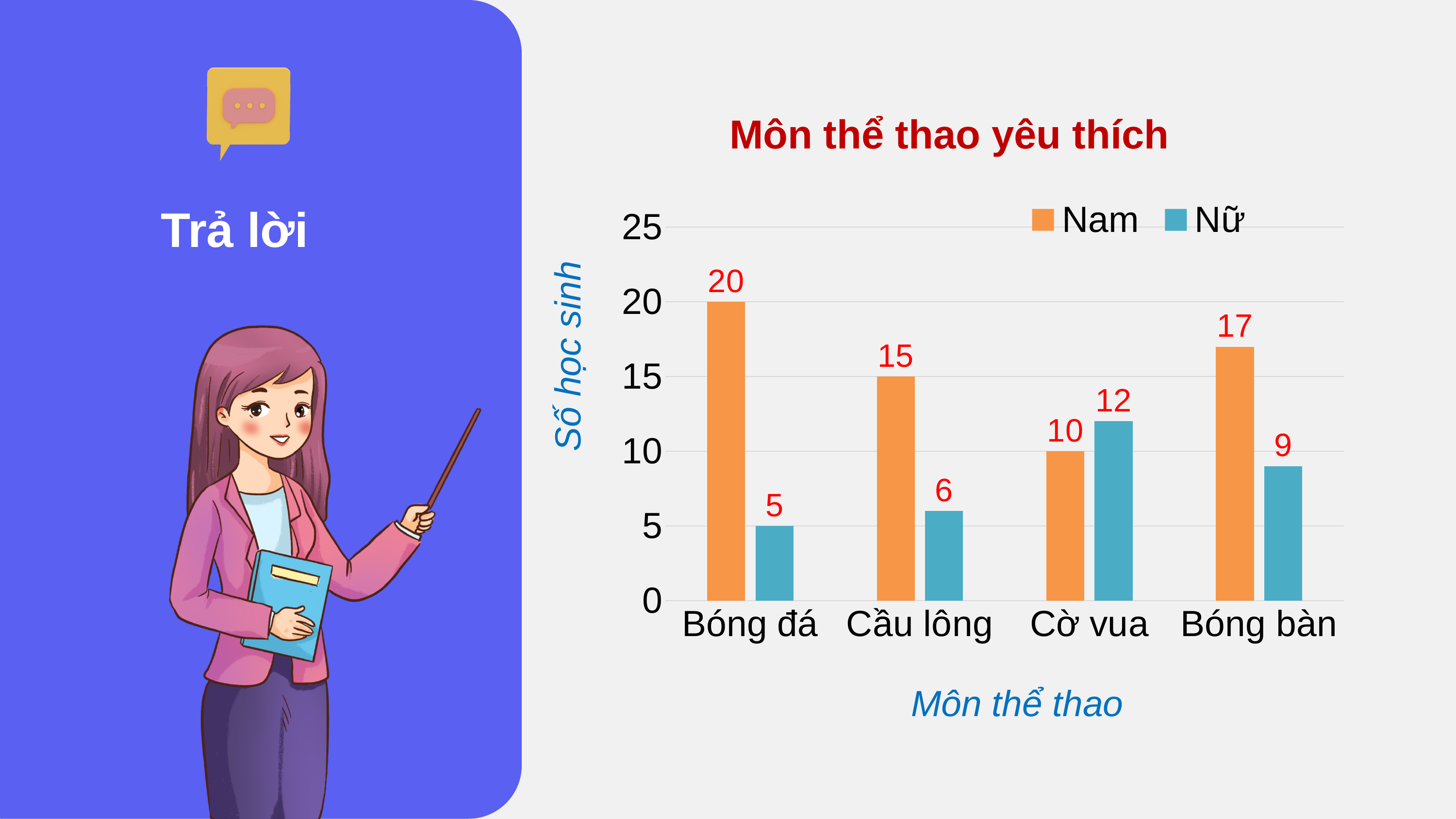
What is the value for Nữ in the Bóng bàn category? 9 Which is larger for Cờ vua, the Nam value or the Nữ value? Nữ What is the label of the vertical axis? Số học sinh Which category has the lowest Nữ value? Bóng đá What is the difference between the Nam and Nữ values for Cầu lông? 9 What is the value for Nữ in the Cờ vua category? 12 How many categories are shown on the x axis? 4 What is the title of the chart? Môn thể thao yêu thích What is the value for Nam in the Bóng đá category? 20 What kind of chart is shown on the slide? Bar chart Which category has the highest Nam value? Bóng đá How many series does the legend list? 2